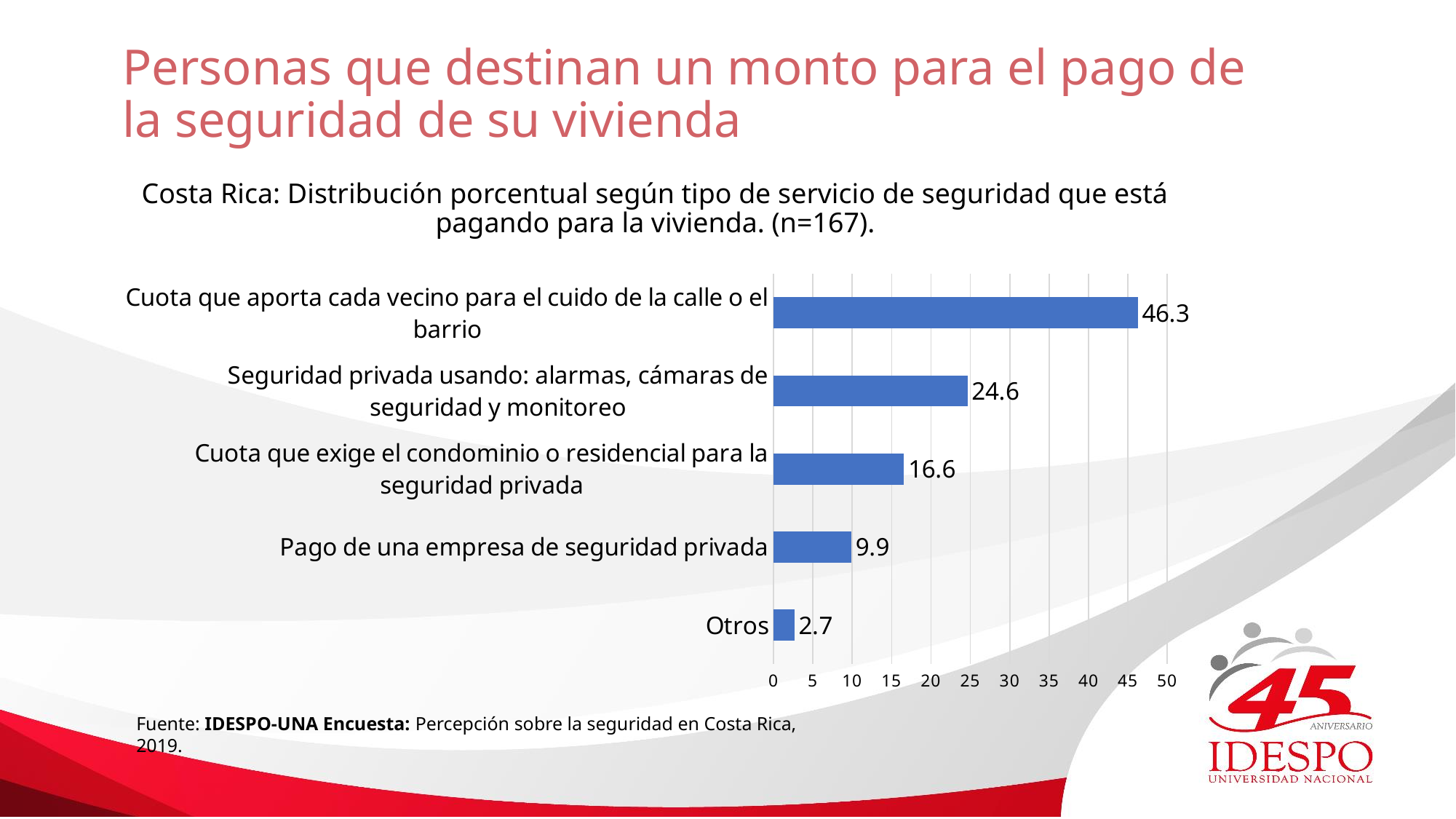
What is the difference between the values for "Cuota que aporta cada vecino para el cuido de la calle o el barrio" and "Seguridad privada usando: alarmas, cámaras de seguridad y monitoreo"? 21.7 Which category has the highest value? Cuota que aporta cada vecino para el cuido de la calle o el barrio What kind of chart is shown on the slide? Bar chart Which is larger: the value for "Cuota que exige el condominio o residencial para la seguridad privada" or for "Pago de una empresa de seguridad privada"? Cuota que exige el condominio o residencial para la seguridad privada What is the difference between the values for "Cuota que exige el condominio o residencial para la seguridad privada" and "Pago de una empresa de seguridad privada"? 6.7 Is the value for "Seguridad privada usando: alarmas, cámaras de seguridad y monitoreo" greater or less than 20? greater What is the value for "Cuota que aporta cada vecino para el cuido de la calle o el barrio"? 46.3 What is the value for "Seguridad privada usando: alarmas, cámaras de seguridad y monitoreo"? 24.6 Which category has the lowest value? Otros How many categories are shown in the chart? 5 What is the value for "Otros"? 2.7 What is the value for "Pago de una empresa de seguridad privada"? 9.9